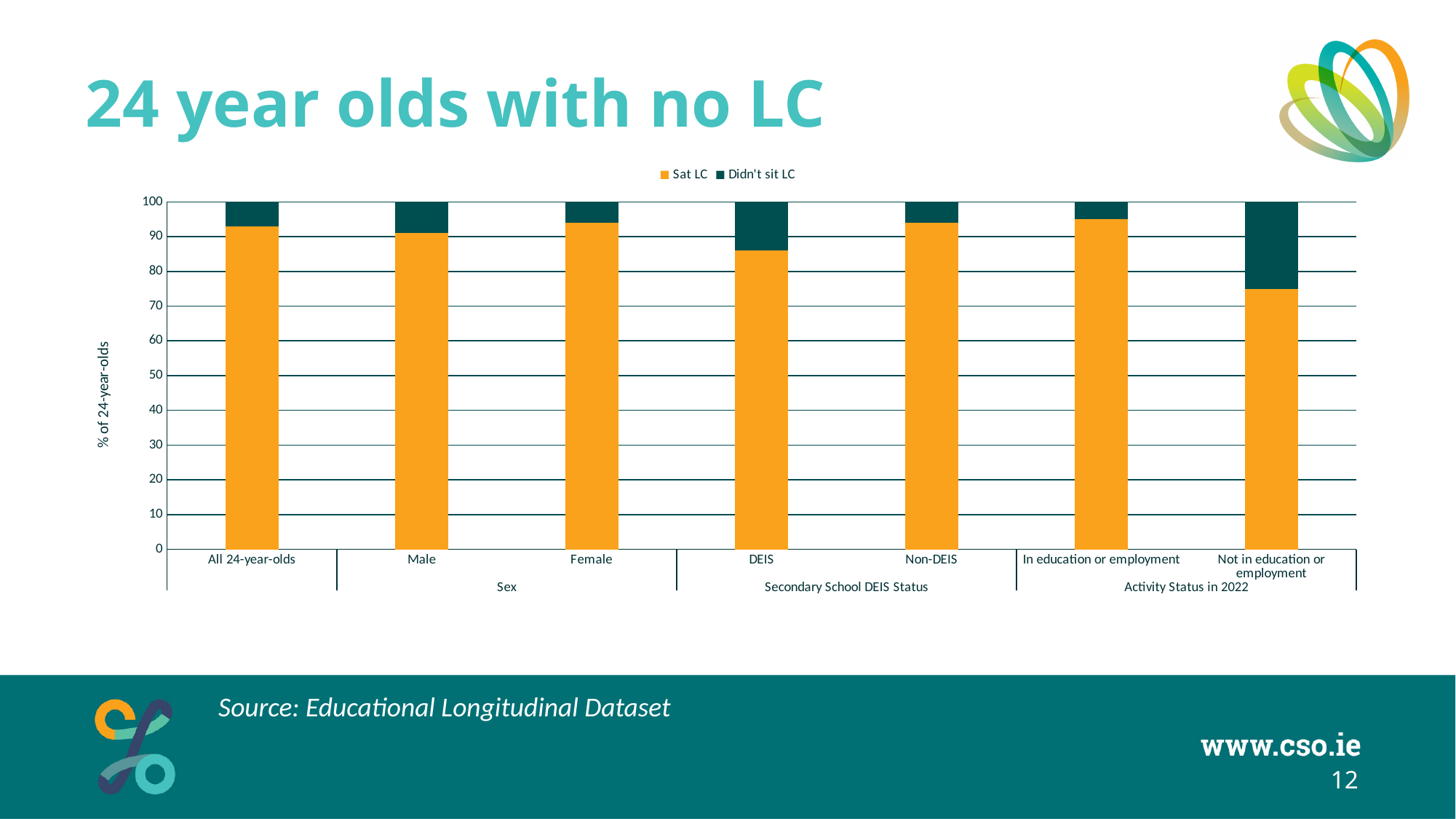
How many series does the legend list? 2 What kind of chart is shown on the slide? Stacked bar chart Is the 'Sat LC' value for DEIS greater or less than 90? less Which category has the lowest 'Sat LC' share? Not in education or employment Which has the larger 'Sat LC' share, DEIS or Non-DEIS? Non-DEIS What is the label on the vertical axis? % of 24-year-olds Which has the larger 'Didn't sit LC' share, Male or Female? Male Is the 'Sat LC' value for 'Not in education or employment' greater or less than 80? less What is the total of the stacked bar for Male? 100 Which category has the highest 'Didn't sit LC' share? Not in education or employment How many categories (bars) are plotted on the chart? 7 Is the 'Sat LC' value for 'All 24-year-olds' greater or less than 90? greater